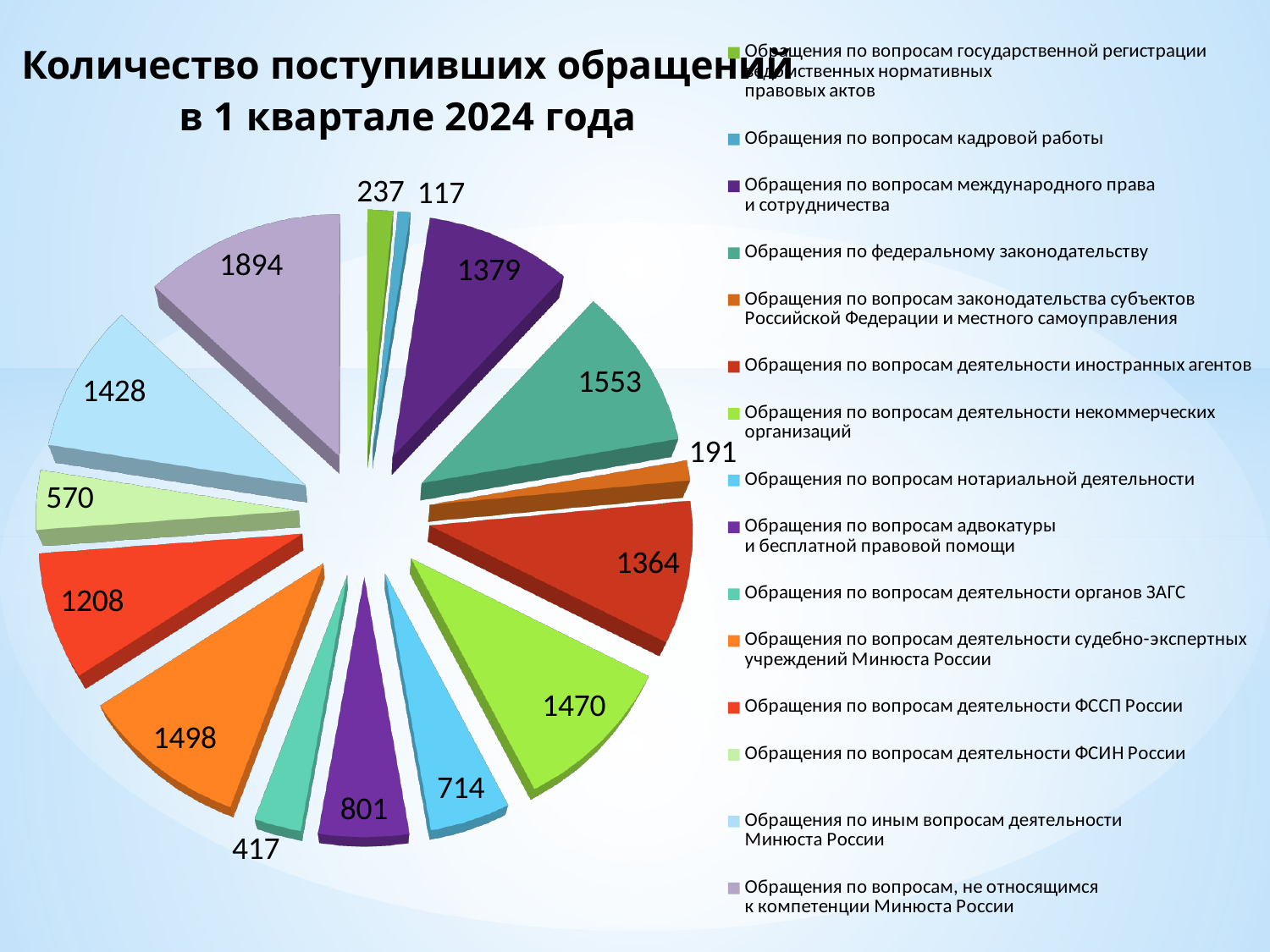
What kind of chart is shown on the slide? Pie chart What is the title of the chart? Количество поступивших обращений в 1 квартале 2024 года What is the smallest value shown on the chart? 117 What is the value for Обращения по вопросам деятельности ФССП России? 1208 What is the value for Обращения по федеральному законодательству? 1553 How many categories does the legend list? 15 Which is larger: the value for Обращения по вопросам международного права и сотрудничества (1379) or the value for Обращения по вопросам деятельности иностранных агентов (1364)? Обращения по вопросам международного права и сотрудничества Which category has the largest value? Обращения по вопросам, не относящимся к компетенции Минюста России Which category has the smallest value? Обращения по вопросам кадровой работы What is the difference between the largest value (1894) and the smallest value (117)? 1777 What is the largest value shown on the chart? 1894 What is the difference between the values 1498 and 1470? 28